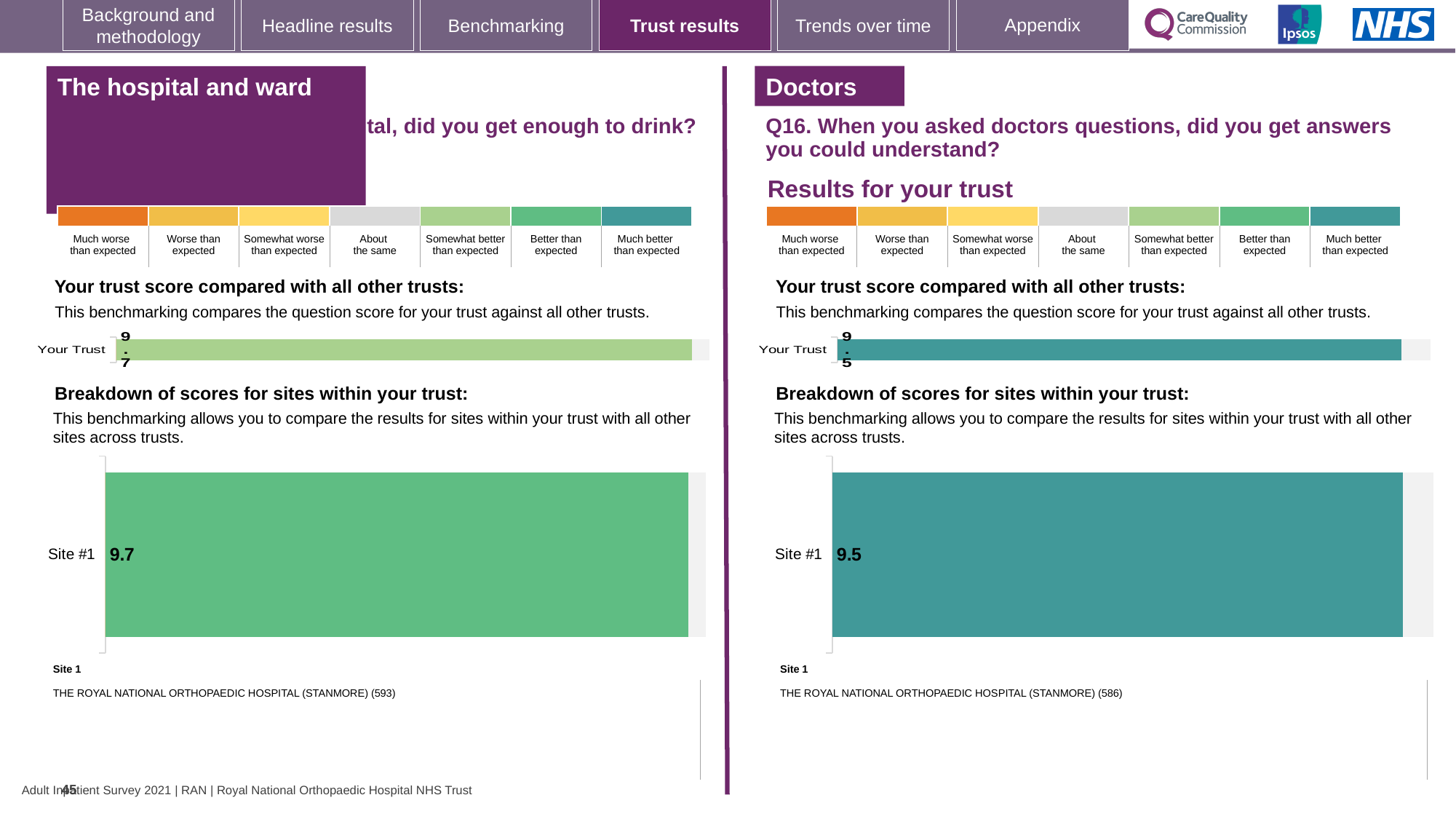
What is the difference between the Site #1 score on the left-hand site breakdown chart and the Site #1 score on the right-hand site breakdown chart? 0.2 Which site name is listed as Site 1 below the right-hand site breakdown chart? THE ROYAL NATIONAL ORTHOPAEDIC HOSPITAL (STANMORE) (586) On the right-hand 'Your trust score compared with all other trusts' chart under Q16, what is the value shown for Your Trust? 9.5 How many sites are shown on the left-hand 'Breakdown of scores for sites within your trust' chart? 1 How many sites are shown on the right-hand 'Breakdown of scores for sites within your trust' chart? 1 Which is larger: the Site #1 score on the left-hand site breakdown chart or the Site #1 score on the right-hand site breakdown chart? The left-hand chart (9.7) On the left-hand 'Your trust score compared with all other trusts' chart, what is the value shown for Your Trust? 9.7 On the right-hand 'Breakdown of scores for sites within your trust' chart under Q16, what is the score for Site #1? 9.5 What type of chart is used to show 'Your Trust' score on the left-hand side of the slide? Bar chart What is the question text shown above the right-hand charts in the 'Doctors' section? Q16. When you asked doctors questions, did you get answers you could understand? What type of chart is used for the site breakdown on the right-hand side of the slide? Bar chart On the left-hand 'Breakdown of scores for sites within your trust' chart, what is the score for Site #1? 9.7